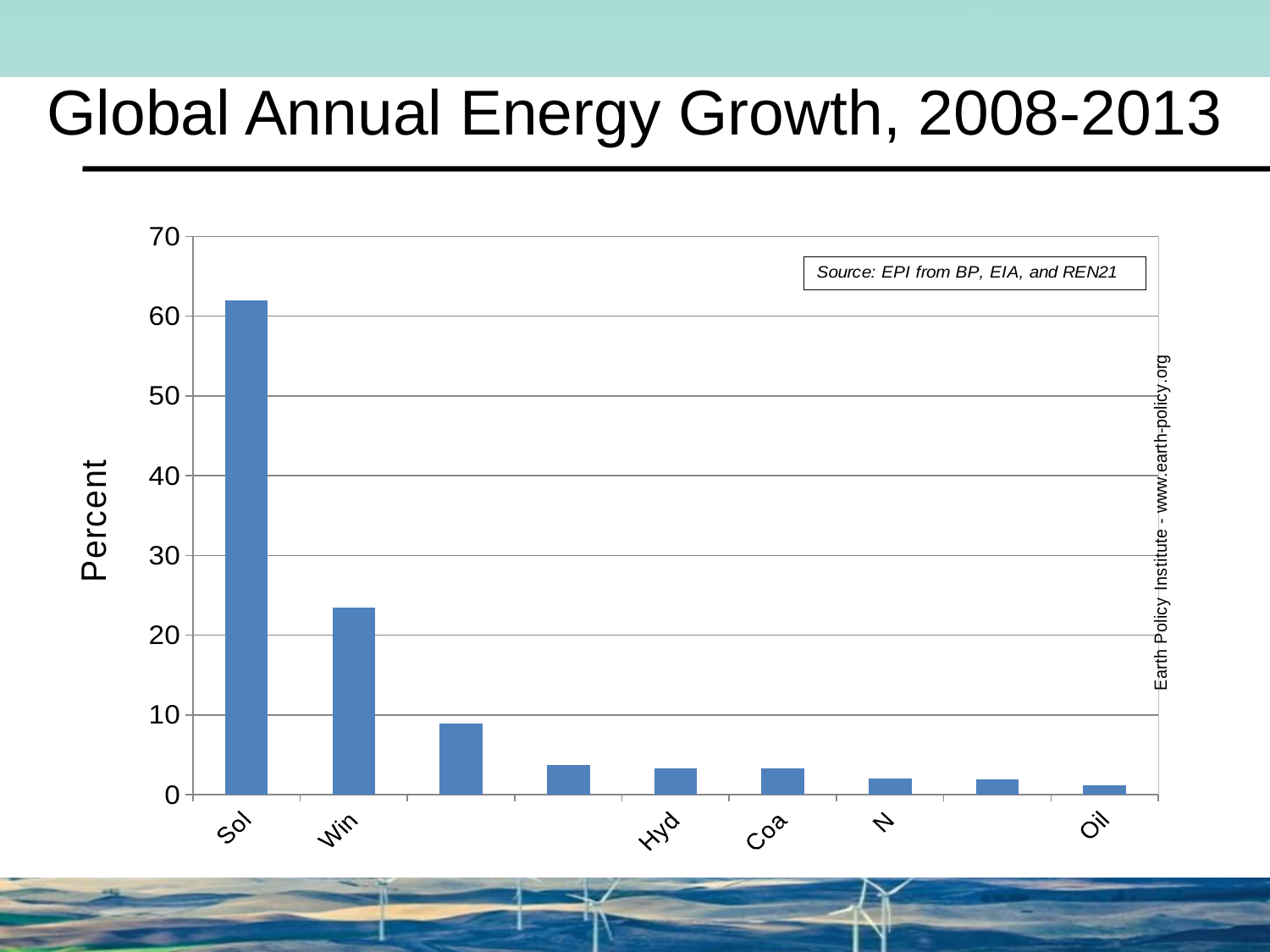
How many bars are plotted in the chart? 9 Which category has the highest value? Sol Do the bar values rise or fall moving from left to right along the x axis? fall Which is larger, the value for Hyd or the value for Oil? Hyd Which is larger, the value for Sol or the value for Win? Sol Is the value for Win greater or less than 30? less Which category has the lowest value? Oil Is the value for Win greater or less than 20? greater Is the value for Sol greater or less than 60? greater What is the label on the vertical axis of the chart? Percent What kind of chart is shown on the slide? bar chart